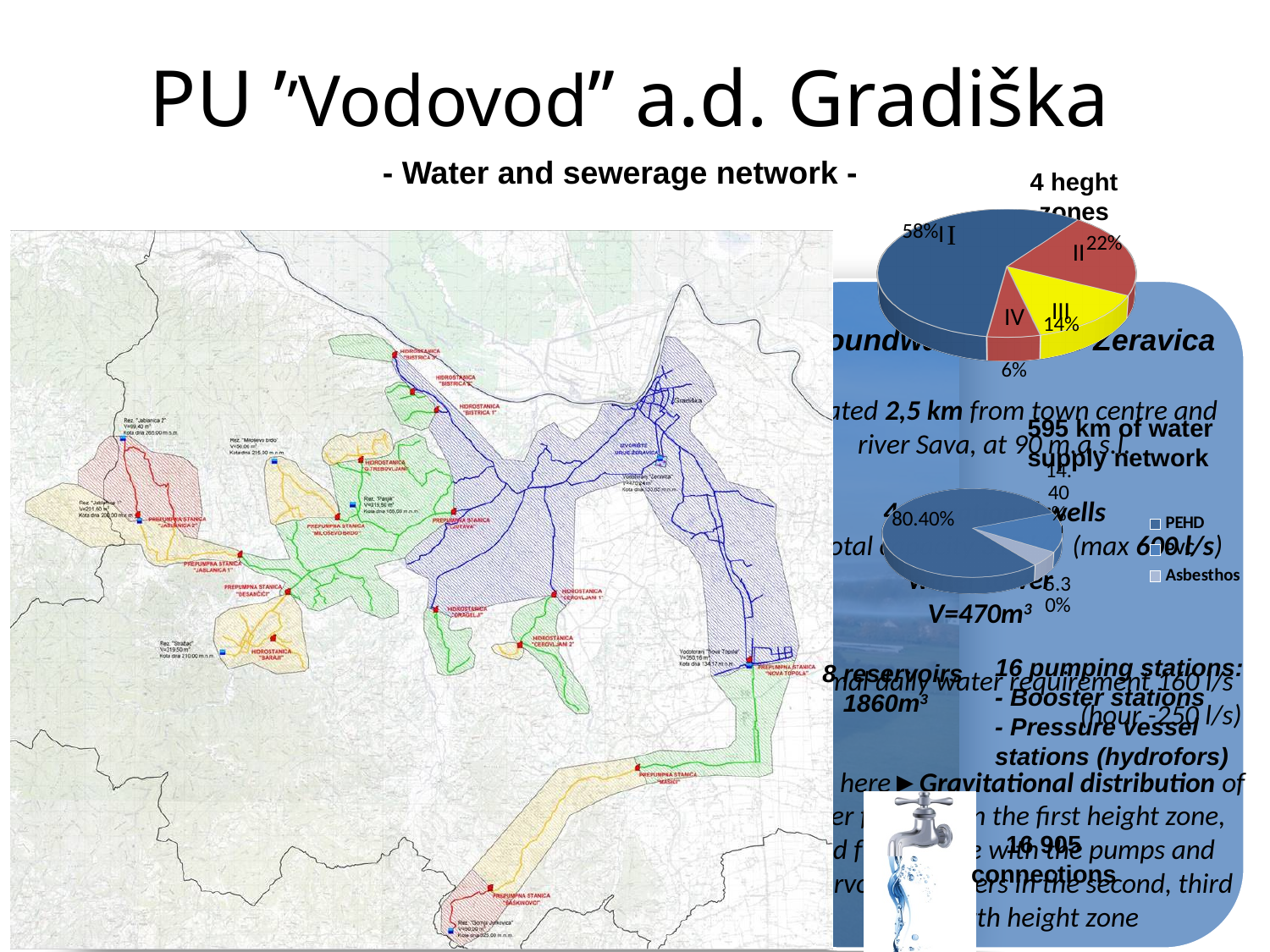
In the lower pie chart (with PEHD, PVC, Asbesthos legend), what is the percentage printed on the largest slice? 80.40% In the '4 heght zones' pie chart, what percentage is shown for zone IV? 6% In the '4 heght zones' pie chart, how many percentage points larger is zone I than zone II? 36 In the '4 heght zones' pie chart, which zone has the largest share? I In the '4 heght zones' pie chart, which is larger, zone II or zone III? II In the '4 heght zones' pie chart, what percentage is shown for zone III? 14% How many slices does the '4 heght zones' pie chart have? 4 What type of chart is the '4 heght zones' chart? Pie chart In the '4 heght zones' pie chart, which zone has the smallest share? IV How many entries does the legend of the lower pie chart (with PEHD, PVC, Asbesthos) list? 3 In the '4 heght zones' pie chart, what percentage is shown for zone I? 58% In the '4 heght zones' pie chart, what percentage is shown for zone II? 22%